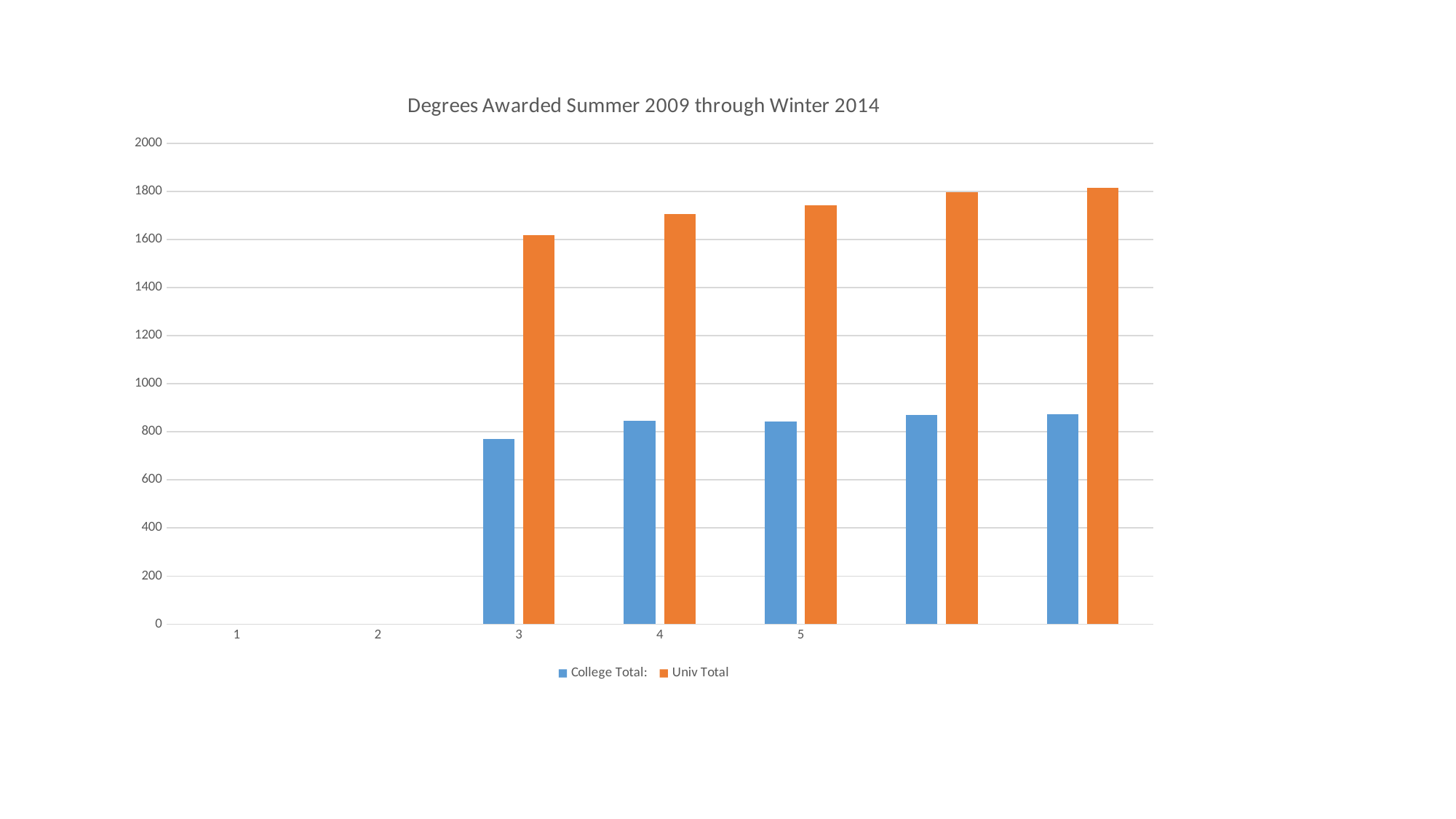
How many series does the legend list? 2 Is the College Total value for category 4 greater or less than 800? greater For category 3, which is larger, College Total or Univ Total? Univ Total Among categories 3, 4 and 5, which has the highest Univ Total? 5 Which is larger, the Univ Total for category 3 or the Univ Total for category 4? category 4 What kind of chart is shown on the slide? bar chart Is the College Total value for category 3 greater or less than 800? less Do the Univ Total values rise or fall from left to right along the x axis? rise Which series is shown in orange? Univ Total What is the title of the chart? Degrees Awarded Summer 2009 through Winter 2014 Is the Univ Total value for category 4 greater or less than 1800? less